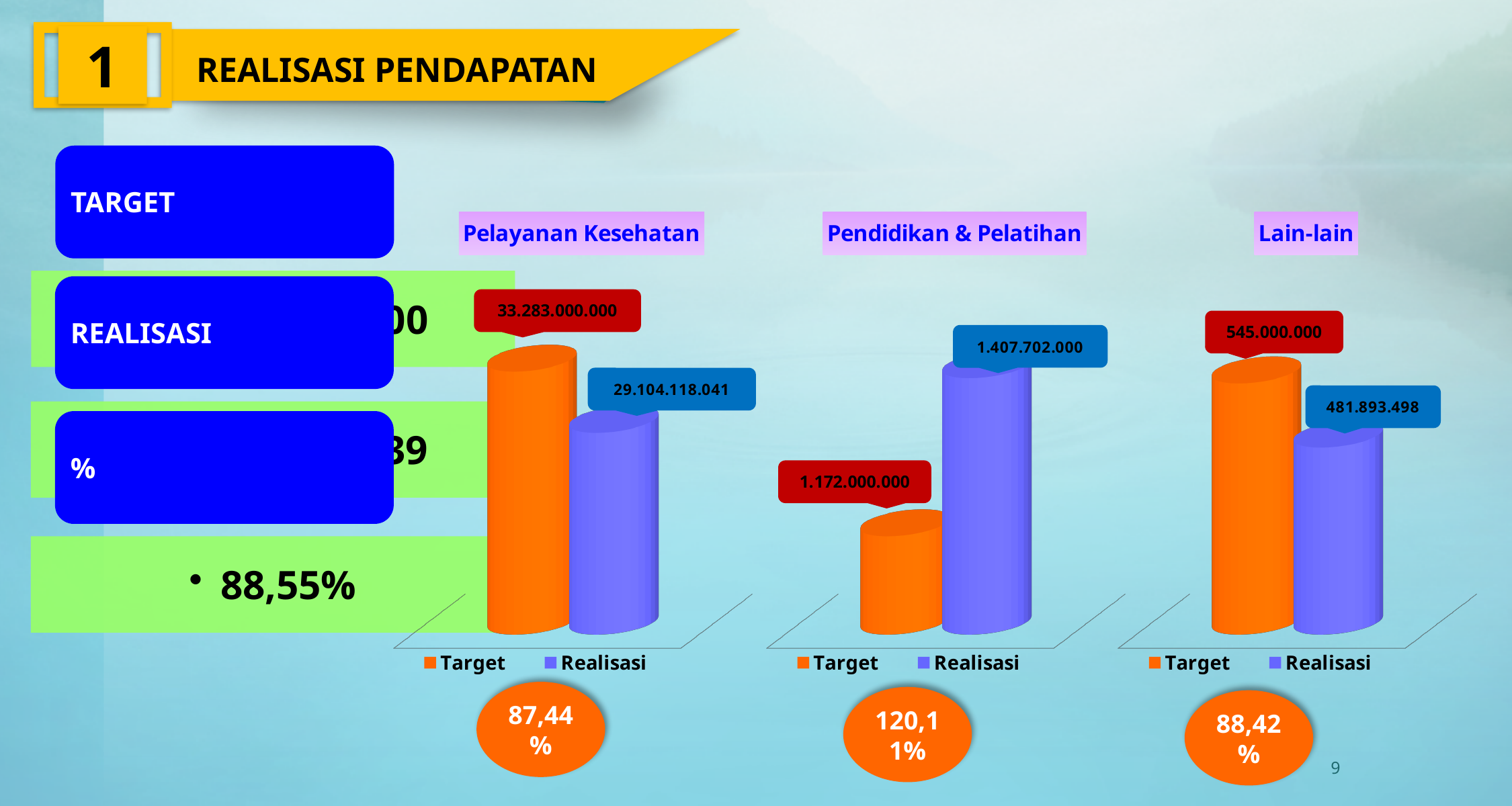
In the Pendidikan & Pelatihan chart, what is the value of the Target bar? 1.172.000.000 In the Pelayanan Kesehatan chart, what is the value of the Realisasi bar? 29.104.118.041 How many series does the legend of the Lain-lain chart list? 2 In the Lain-lain chart, what is the value of the Target bar? 545.000.000 What kind of chart is the Pelayanan Kesehatan chart? Bar chart In the Pelayanan Kesehatan chart, what is the difference between the Target and Realisasi values? 4.178.881.959 In the Pendidikan & Pelatihan chart, by how much does Realisasi exceed Target? 235.702.000 In the Pendidikan & Pelatihan chart, what is the value of the Realisasi bar? 1.407.702.000 In the Pelayanan Kesehatan chart, what is the value of the Target bar? 33.283.000.000 In the Pendidikan & Pelatihan chart, which bar is higher, Target or Realisasi? Realisasi In the Lain-lain chart, which bar is lower, Target or Realisasi? Realisasi In the Lain-lain chart, what is the value of the Realisasi bar? 481.893.498